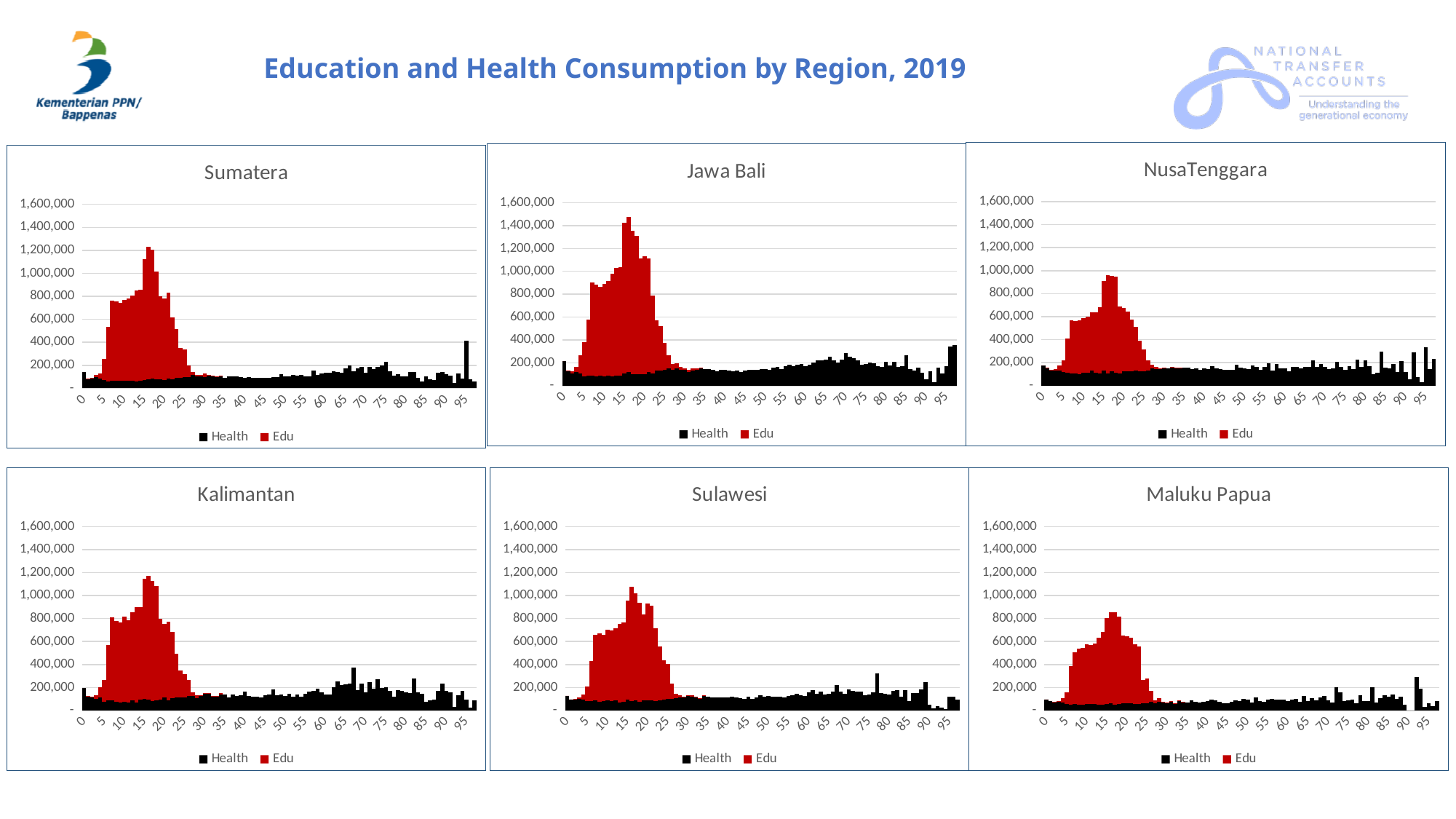
In the Sumatera chart, is the peak Edu value greater or less than 1,000,000? greater In the Sulawesi chart, which colour represents the Edu series? red What kind of chart is the Sumatera chart? bar chart How many series does the legend of the Jawa Bali chart list? 2 In the NusaTenggara chart, is the peak Edu value greater or less than 1,200,000? less What are the legend entries in the Kalimantan chart? Health, Edu In the Sumatera chart, do the Edu values rise or fall between age 20 and age 30? fall In the Maluku Papua chart, is the peak Edu value greater or less than 1,000,000? less Across the six charts, which region has the highest peak Edu value? Jawa Bali How many charts are shown on the slide? 6